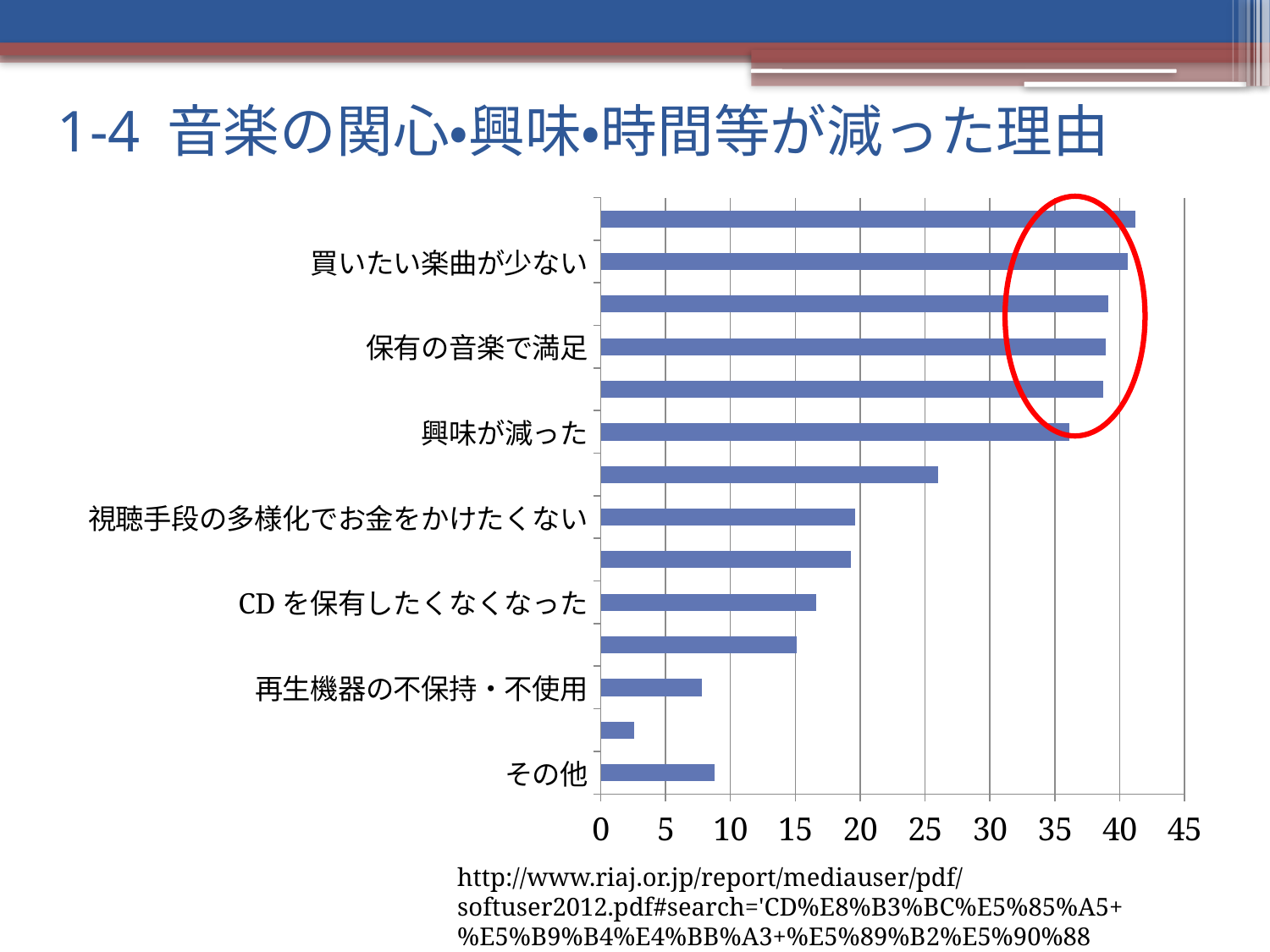
What is the title of the slide containing the chart? 1-4 音楽の関心•興味•時間等が減った理由 What kind of chart is shown on the slide? bar chart What is the highest value shown on the horizontal axis? 45 Which is larger, the value for 保有の音楽で満足 or the value for CDを保有したくなくなった? 保有の音楽で満足 Is the value for 視聴手段の多様化でお金をかけたくない greater or less than 15? greater How many bars are plotted in the chart? 14 Is the value for 保有の音楽で満足 greater or less than 35? greater Is the value for 興味が減った greater or less than 40? less Which is larger, the value for 買いたい楽曲が少ない or the value for 興味が減った? 買いたい楽曲が少ない